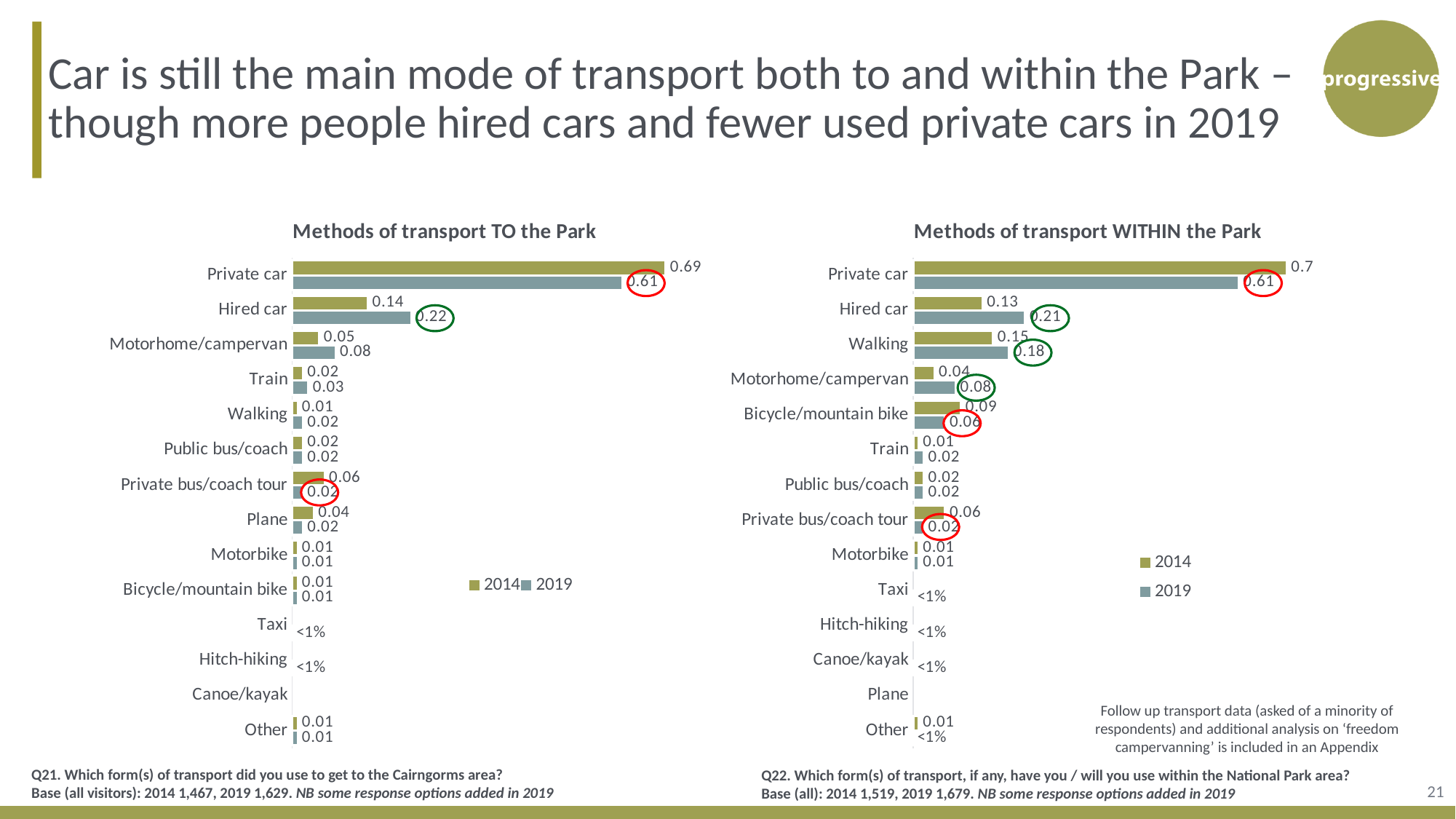
In the 'Methods of transport WITHIN the Park' chart, what is the 2019 value for Walking? 0.18 In the 'Methods of transport TO the Park' chart, which is larger for Private bus/coach tour: the 2014 value or the 2019 value? 2014 In the 'Methods of transport TO the Park' chart, what is the difference between the 2014 and 2019 values for Hired car? 0.08 How many categories are shown in the 'Methods of transport TO the Park' chart? 14 In the 'Methods of transport WITHIN the Park' chart, what is the 2014 value for Private car? 0.7 In the 'Methods of transport TO the Park' chart, what is the 2014 value for Hired car? 0.14 What type of chart is 'Methods of transport TO the Park'? Bar chart In the 'Methods of transport TO the Park' chart, which category has the highest 2014 value? Private car In the 'Methods of transport WITHIN the Park' chart, what is the difference between the 2014 and 2019 values for Private car? 0.09 In the 'Methods of transport WITHIN the Park' chart, which is larger for Bicycle/mountain bike: the 2014 value or the 2019 value? 2014 In the 'Methods of transport TO the Park' chart, what is the 2019 value for Private car? 0.61 How many series does the legend list in the 'Methods of transport WITHIN the Park' chart? 2